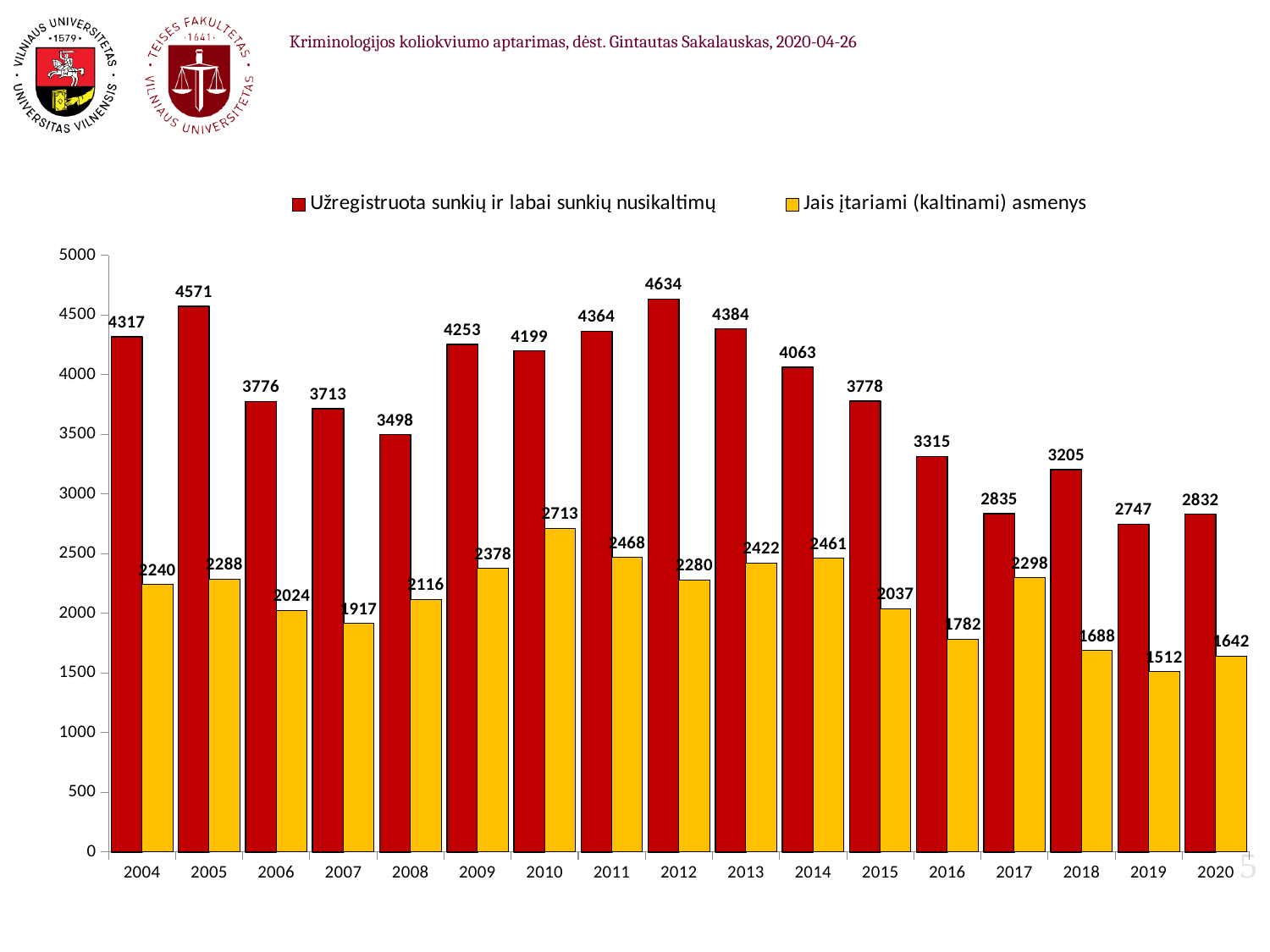
In which year is 'Užregistruota sunkių ir labai sunkių nusikaltimų' highest? 2012 What is the difference between 'Užregistruota sunkių ir labai sunkių nusikaltimų' and 'Jais įtariami (kaltinami) asmenys' in 2012? 2354 What kind of chart is shown on the slide? bar chart In which year is 'Jais įtariami (kaltinami) asmenys' lowest? 2019 Which colour represents 'Jais įtariami (kaltinami) asmenys' in the chart? yellow What is the value of 'Jais įtariami (kaltinami) asmenys' for 2019? 1512 How many years are shown on the x axis? 17 How many series does the legend list? 2 Which is larger: 'Užregistruota sunkių ir labai sunkių nusikaltimų' in 2005 or in 2009? 2005 What is the value of 'Užregistruota sunkių ir labai sunkių nusikaltimų' for 2012? 4634 In which year is 'Jais įtariami (kaltinami) asmenys' highest? 2010 Is the value of 'Užregistruota sunkių ir labai sunkių nusikaltimų' for 2016 greater or less than 3500? less